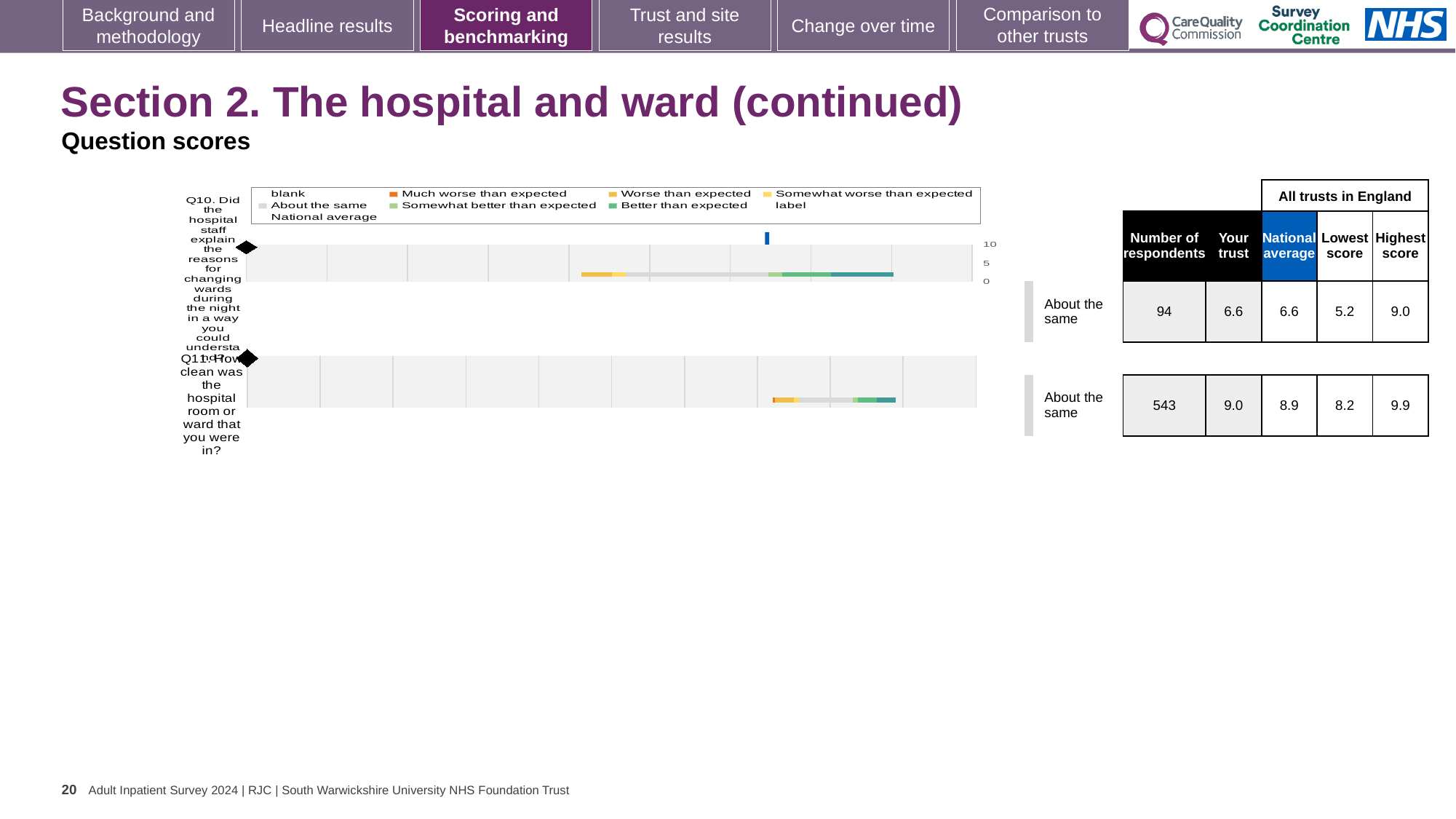
How many entries does the chart legend list? 9 What kind of chart is used to show the question scores on this slide? bar chart How many questions (categories) are plotted in the chart? 2 What is the lowest score among all trusts in England for Q10? 5.2 What is the difference between the highest and lowest scores for Q10? 3.8 What benchmark category is shown next to both Q10 and Q11? About the same What is the national average score for Q10 (Did the hospital staff explain the reasons for changing wards during the night)? 6.6 For Q11, which is larger: the trust's score or the national average? Your trust How many respondents answered Q11? 543 What is the 'Your trust' score for Q11 (How clean was the hospital room or ward that you were in?)? 9.0 Is the trust's score for Q11 greater or less than 5 on the chart axis? greater Which question has the higher 'Your trust' score, Q10 or Q11? Q11